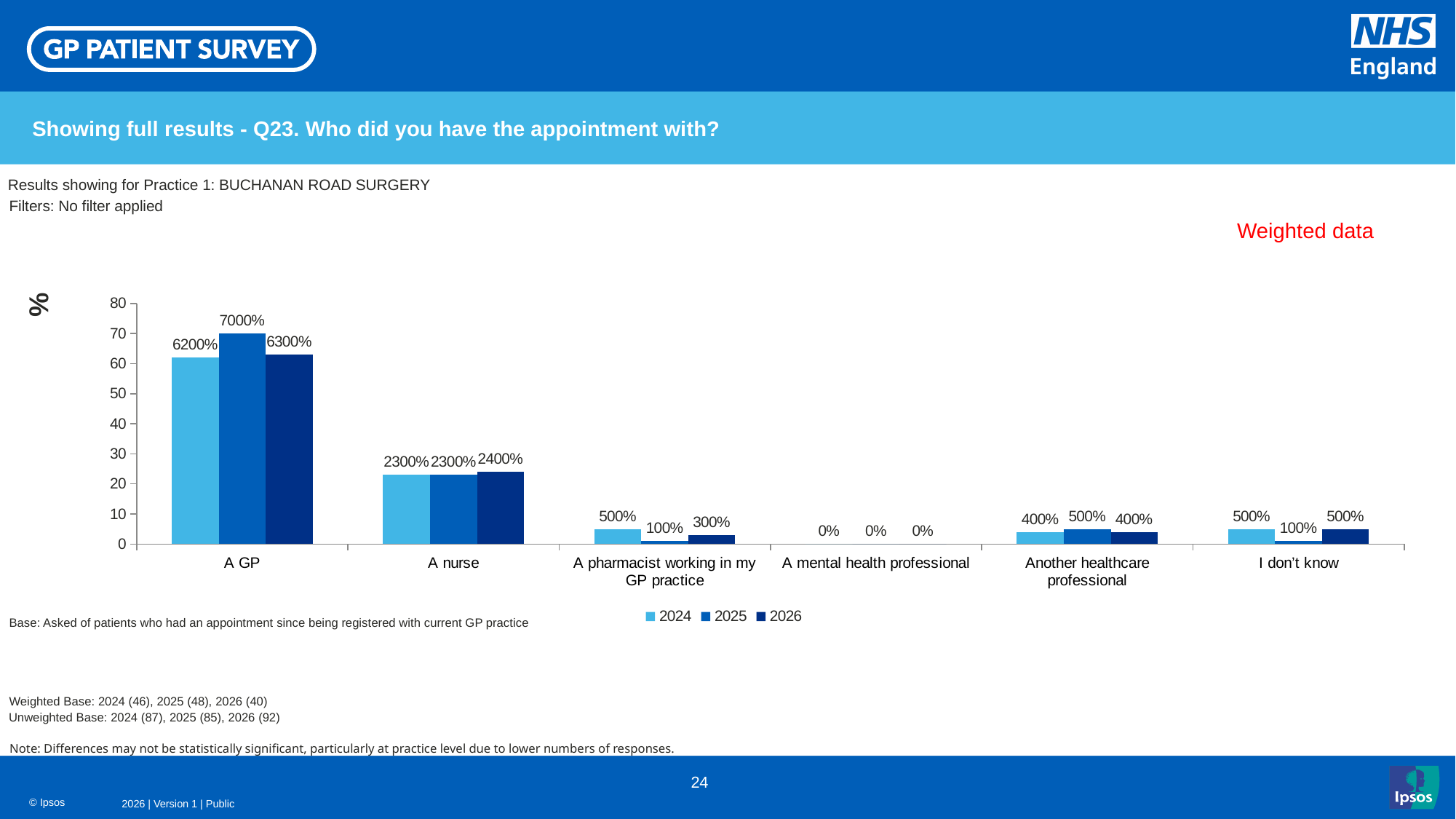
Which category has the highest value in the 2024 series? A GP How many categories are shown on the x axis? 6 What kind of chart is shown on the slide? Bar chart What are the series names listed in the legend? 2024, 2025, 2026 Which category has the lowest value in the 2026 series? A mental health professional Which is larger for 'A GP': the 2024 bar or the 2025 bar? 2025 What is the data label shown for 'A nurse' in the 2026 series? 2400% What is the data label shown for 'A mental health professional' in the 2024 series? 0% What is the data label shown for 'A GP' in the 2025 series? 7000% What is the data label shown for 'A pharmacist working in my GP practice' in the 2025 series? 100% Is the 2026 bar for 'A GP' greater or less than 60 on the axis? greater How many series does the legend list? 3